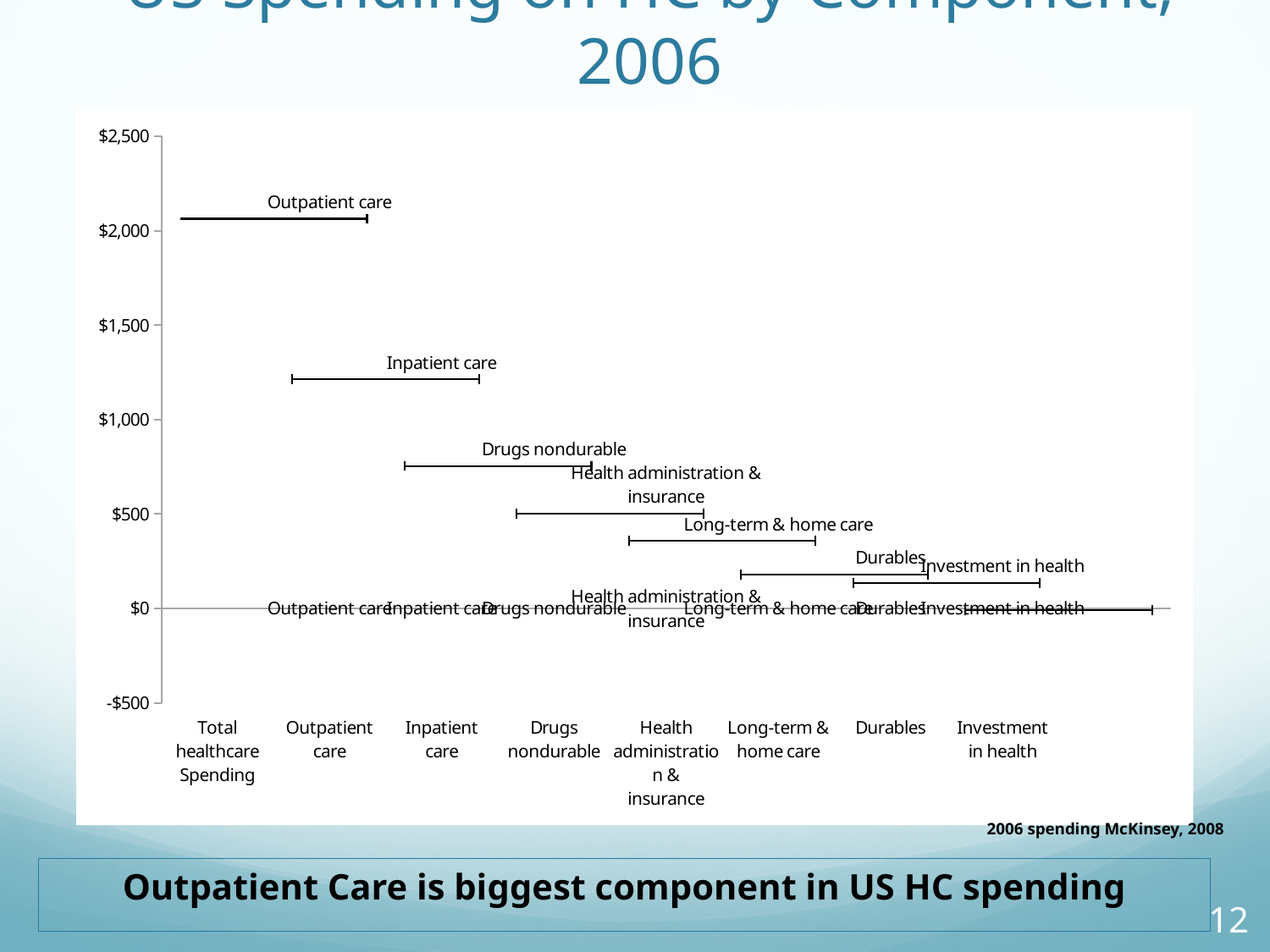
Moving from Outpatient care to Investment in health along the x axis, do the component values rise or fall? fall Is the value for Inpatient care greater or less than $1,500? less Is the value for Drugs nondurable greater or less than $1,000? less Is the value for Long-term & home care greater or less than $500? less What is the highest value shown on the y axis of the chart? $2,500 Which is larger, the value for Outpatient care or the value for Inpatient care? Outpatient care Which is larger, the value for Drugs nondurable or the value for Long-term & home care? Drugs nondurable Which component has the highest spending in the chart? Outpatient care How many categories are shown on the x axis of the chart? 8 What source is cited below the chart? 2006 spending McKinsey, 2008